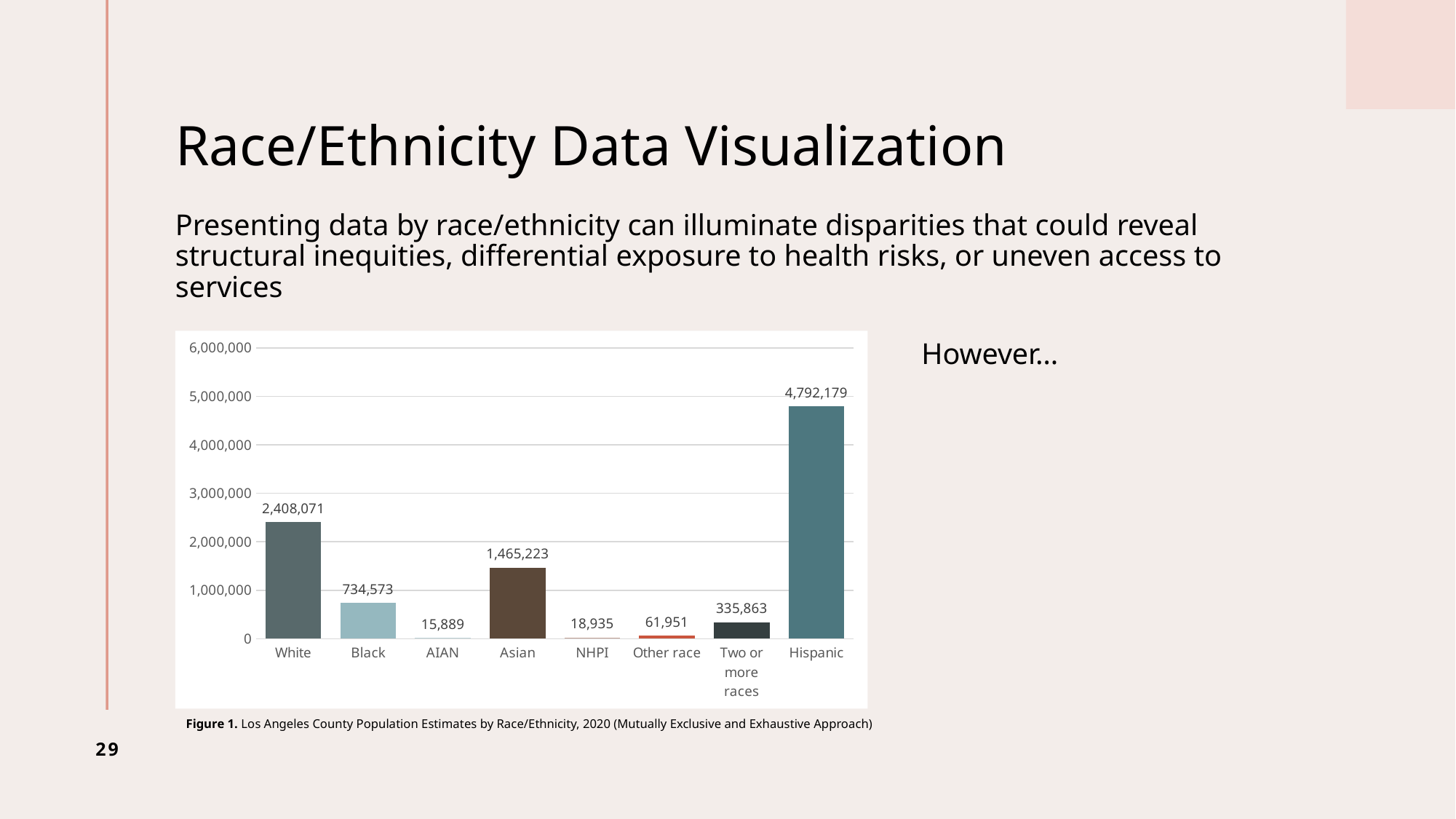
What is the population estimate for White in the chart? 2,408,071 What is the population estimate for Asian in the chart? 1,465,223 Which race/ethnicity category has the highest population estimate? Hispanic Which is larger, the value for Black or the value for Two or more races? Black What kind of chart is shown on the slide? Bar chart Is the value for White greater or less than 2,000,000? greater What is the difference between the Asian and Black population estimates? 730,650 How many race/ethnicity categories are shown in the chart? 8 What is the value shown for Two or more races? 335,863 What is the difference between the Hispanic and White population estimates? 2,384,108 What year does the figure caption say the population estimates are for? 2020 Which race/ethnicity category has the lowest population estimate? AIAN